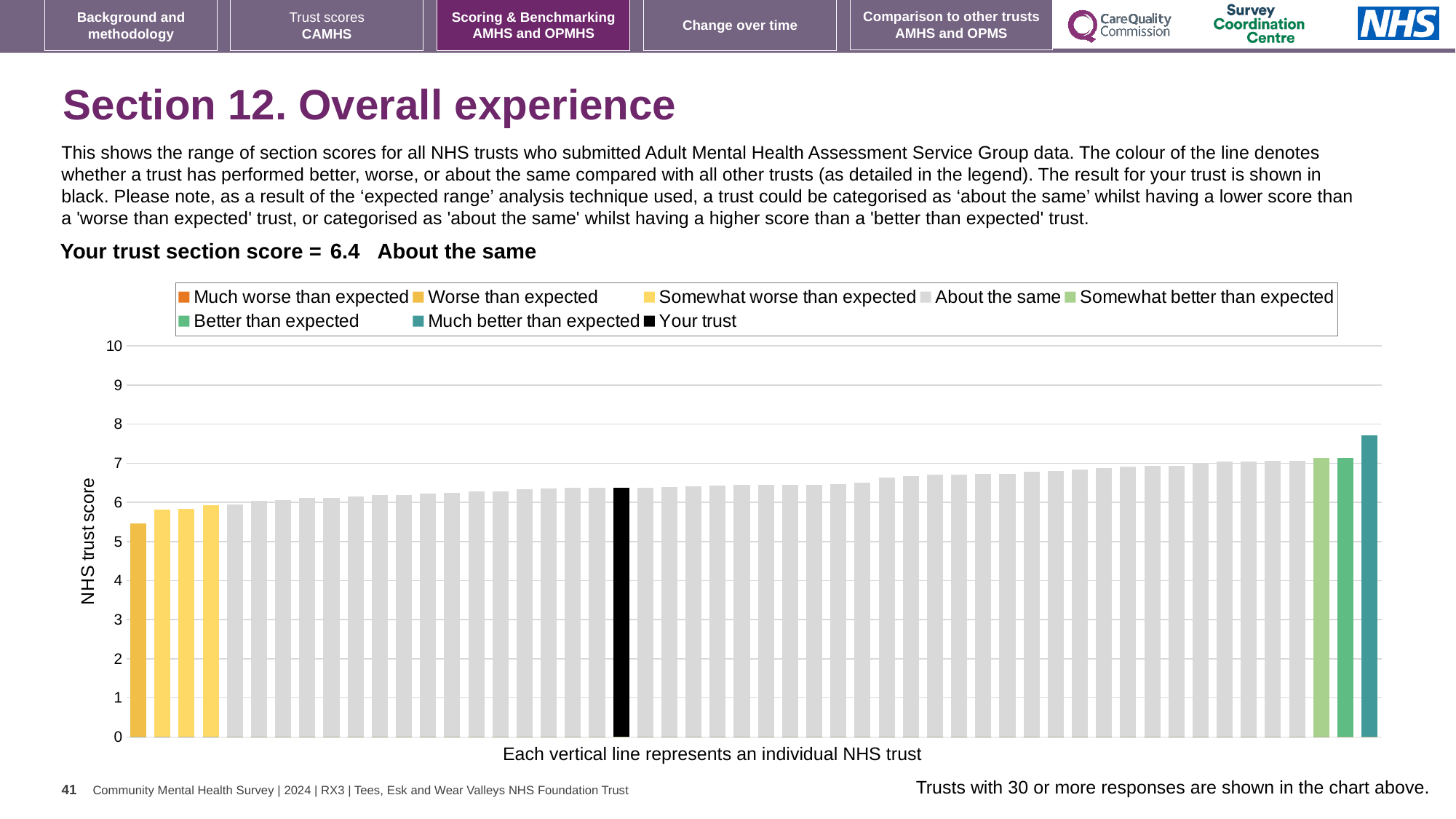
What is the label on the y axis of the chart? NHS trust score Is the value of the shortest bar in the chart greater or less than 6? less Is the value of the tallest bar in the chart greater or less than 7? greater How many entries does the chart legend list? 8 How many bars are coloured as 'Worse than expected' (yellow)? 1 Do the bar values rise or fall from left to right along the x axis? rise Is the value of the tallest bar in the chart greater or less than 8? less What kind of chart is shown on the slide? bar chart Which performance category is your trust placed in according to the slide? About the same How many bars are coloured as 'Much better than expected' (teal)? 1 What is your trust's section score shown on the slide? 6.4